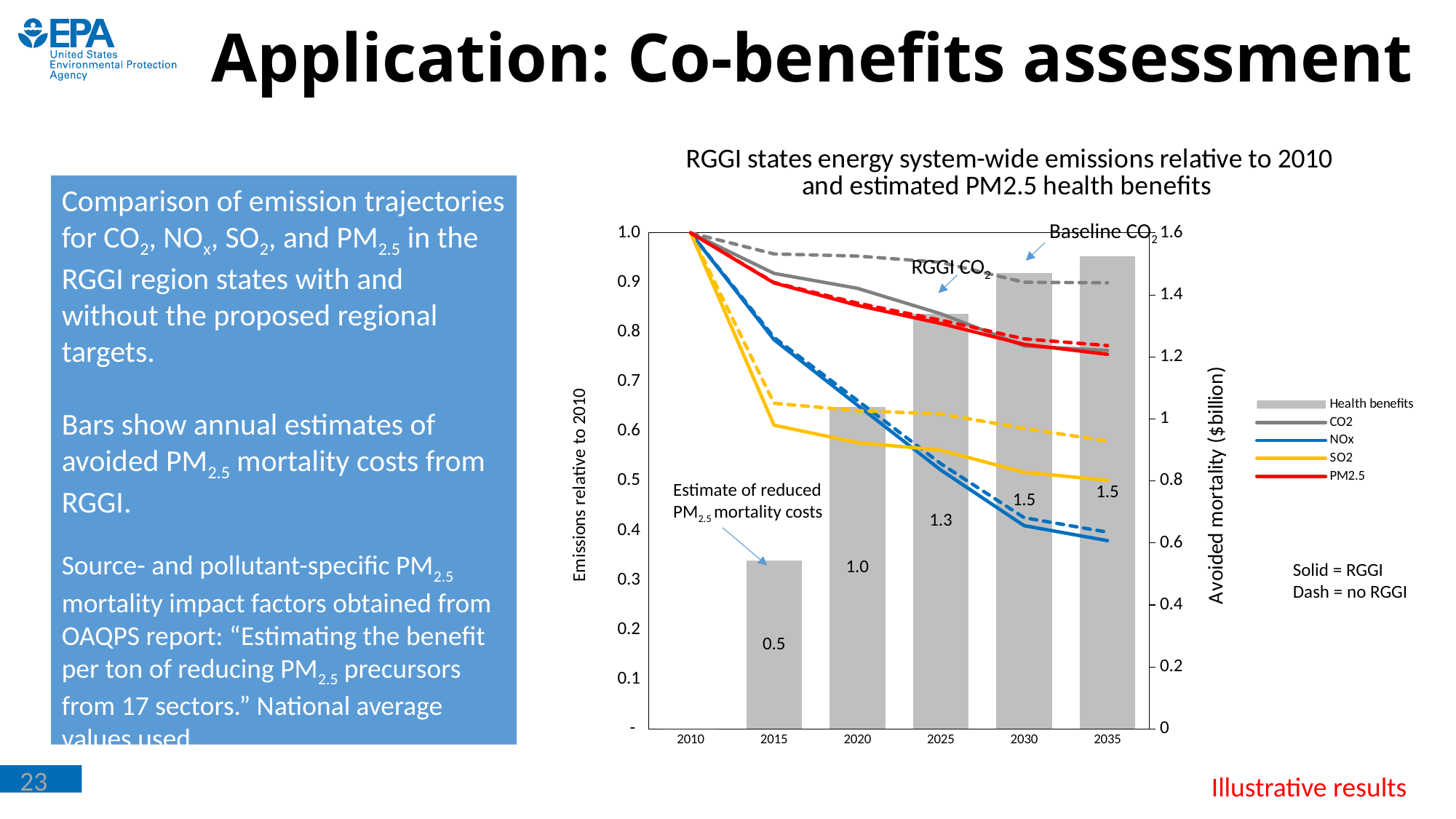
What is the difference between the Health benefits values for 2025 and 2015? 0.8 Do the Health benefits bars rise or fall from 2015 to 2030? rise Is the solid NOx emissions value in 2035 greater or less than 0.5? less What is the Health benefits value for 2015? 0.5 What is the Health benefits value for 2020? 1.0 Is the Health benefits value for 2020 larger or smaller than the value for 2025? smaller What is the Health benefits value for 2025? 1.3 Does the solid NOx line rise or fall from 2010 to 2035? fall What is the title of the chart? RGGI states energy system-wide emissions relative to 2010 and estimated PM2.5 health benefits Which year has the lowest Health benefits bar? 2015 How many years are shown on the x axis? 6 How many series does the legend list? 5